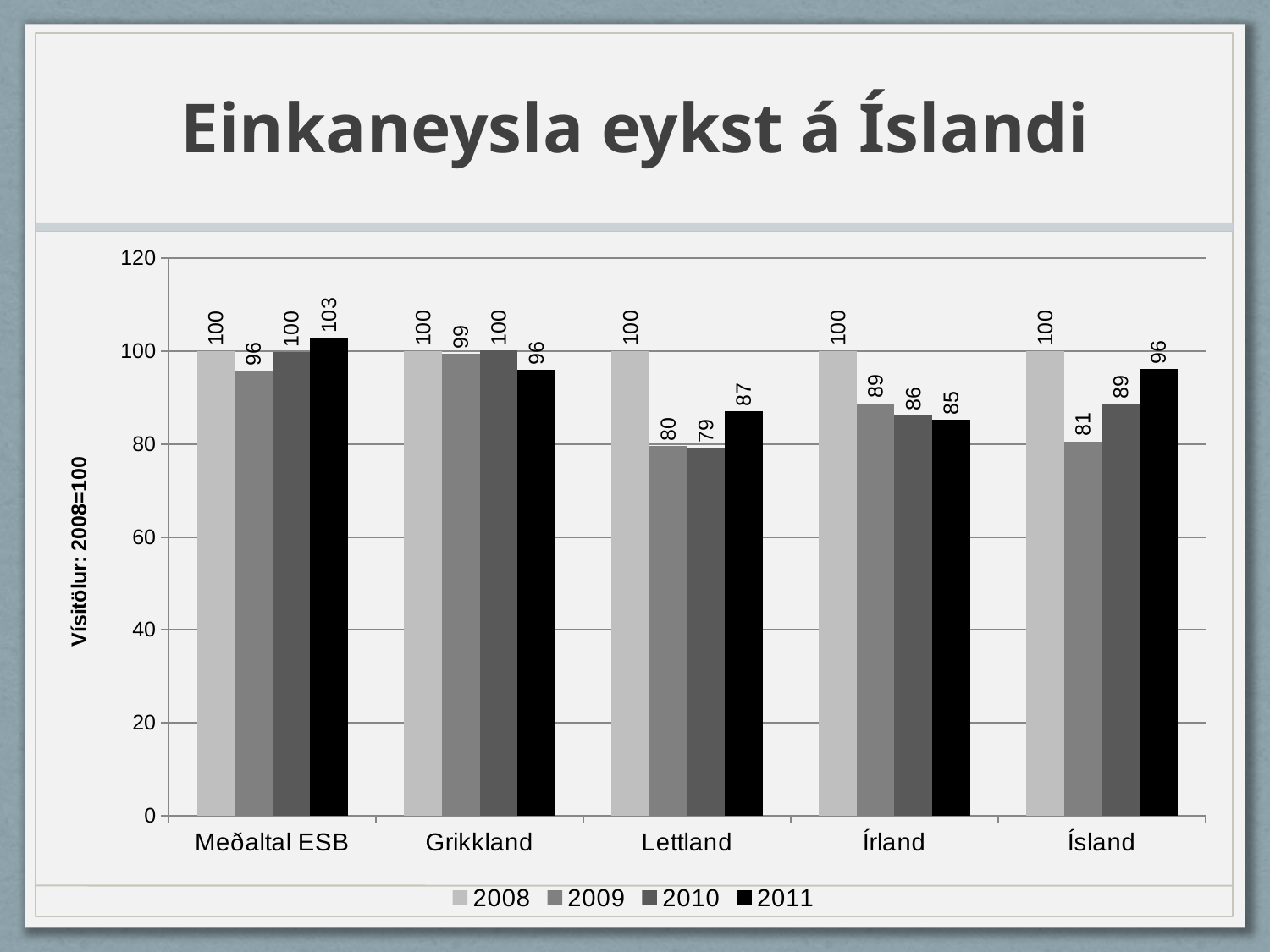
How many series does the legend list? 4 What is the label of the vertical axis? Vísitölur: 2008=100 What is the value for Írland in 2009? 89 What is the value for Lettland in 2010? 79 What is the difference between the 2011 and 2009 values for Ísland? 15 What kind of chart is shown on the slide? bar chart Which is larger, the 2011 value for Grikkland or the 2011 value for Írland? Grikkland What is the value for Ísland in 2011? 96 How many categories are shown on the x axis? 5 Which category has the highest value in 2011? Meðaltal ESB What is the value for Meðaltal ESB in 2011? 103 Which category has the lowest value in 2009? Lettland